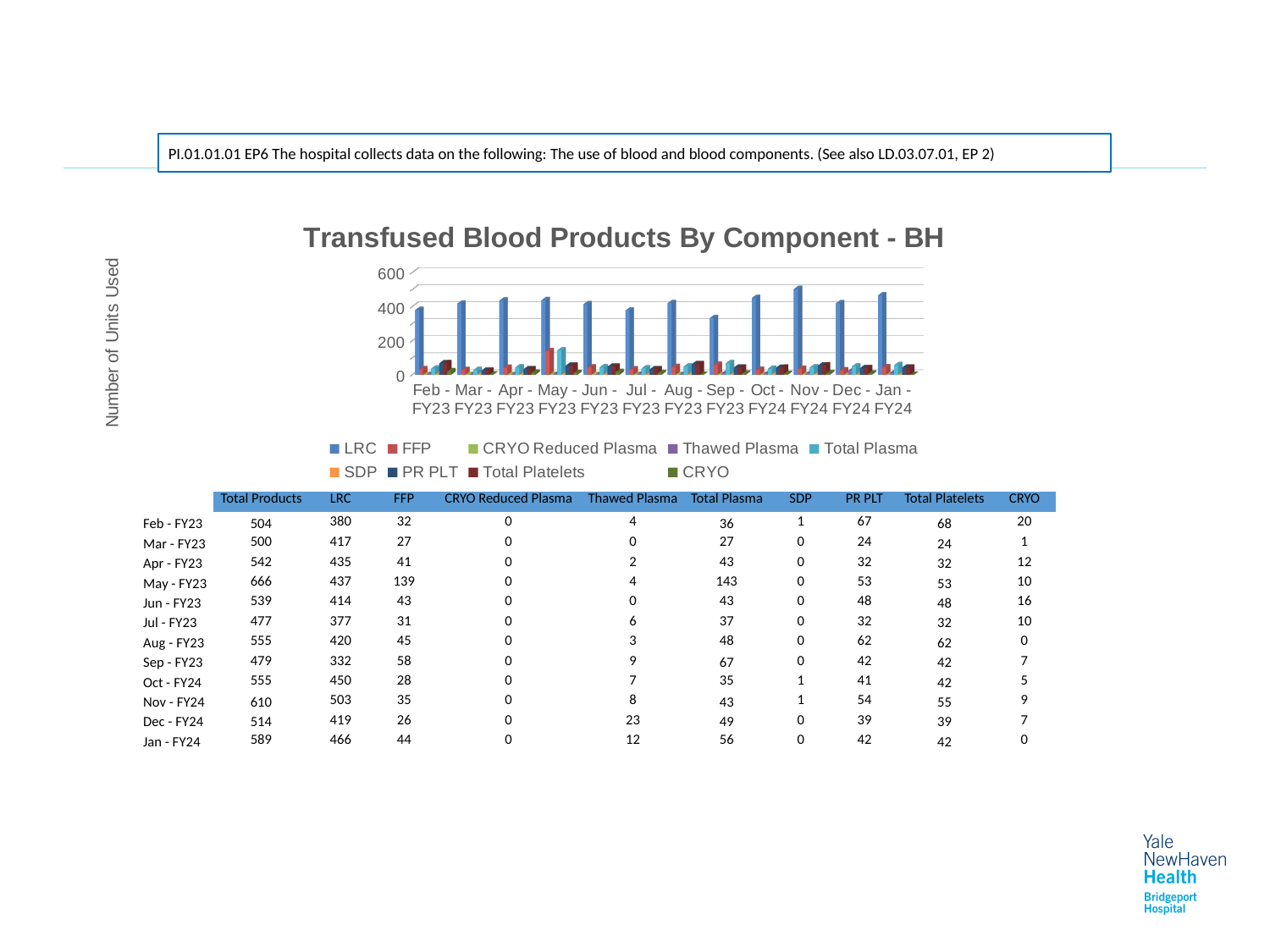
What type of chart is shown on the slide? bar chart What is the title of the chart? Transfused Blood Products By Component - BH What is the FFP value for May - FY23? 139 Which month has the lowest LRC value? Sep - FY23 Which month has the highest LRC value? Nov - FY24 How many series does the chart legend list? 9 Is the LRC value for Sep - FY23 greater or less than 400? less Do the LRC values rise or fall from Sep - FY23 to Nov - FY24? rise How many months (categories) are plotted along the x axis? 12 What is the LRC value for Nov - FY24? 503 Which is larger, the LRC value for Feb - FY23 or the LRC value for Mar - FY23? Mar - FY23 What is the difference between the LRC value for Nov - FY24 and the LRC value for Sep - FY23? 171